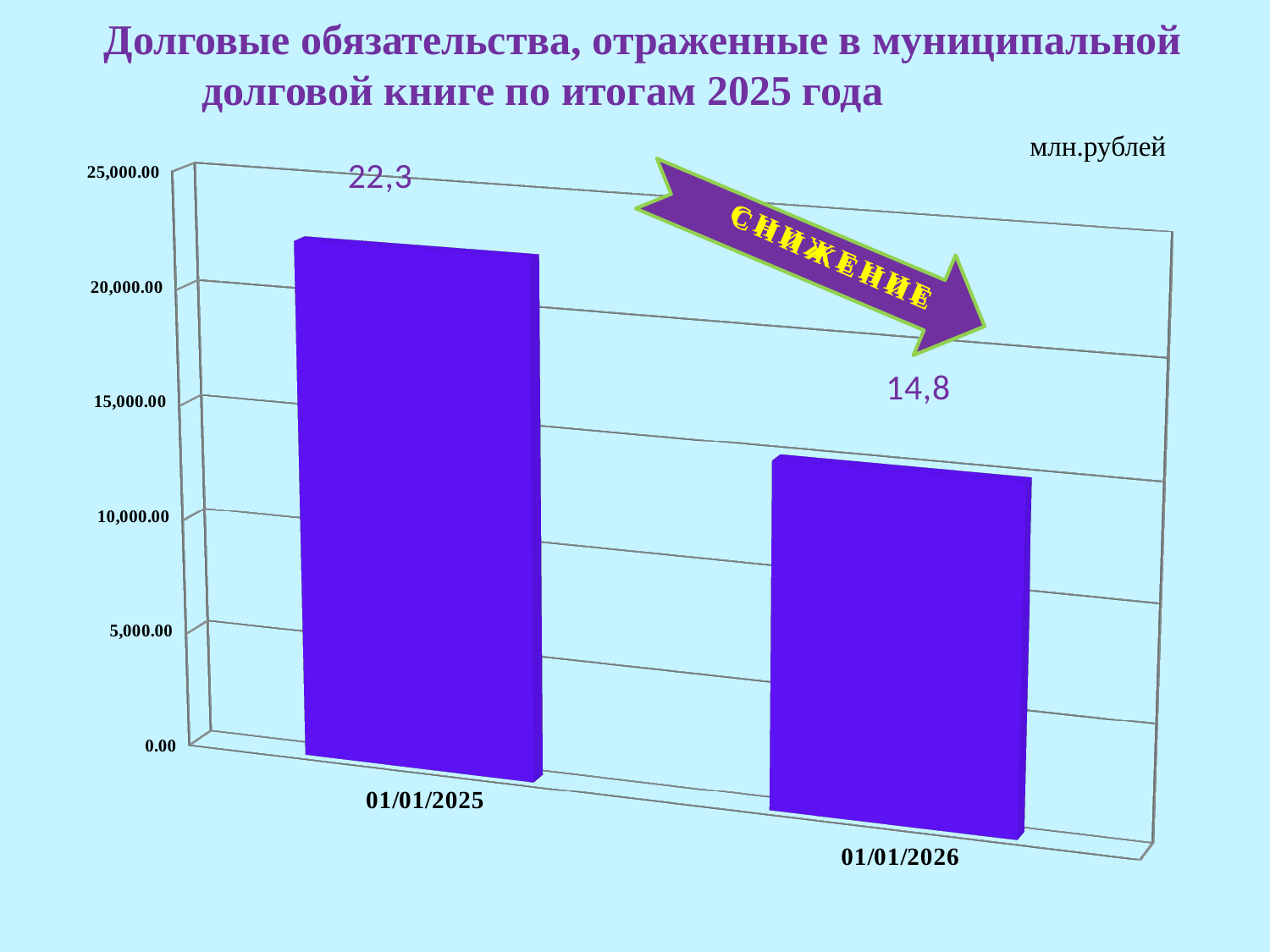
What unit of measurement is indicated on the slide for the chart values? млн.рублей What is the difference between the labelled values for 01/01/2025 and 01/01/2026? 7,5 Which category has the lowest value on the chart? 01/01/2026 Is the bar for 01/01/2025 greater or less than 20,000.00 on the axis? greater How many bars are shown on the chart? 2 What value is labelled on the bar for 01/01/2026? 14,8 Which category has the highest value on the chart? 01/01/2025 Which date has the higher value, 01/01/2025 or 01/01/2026? 01/01/2025 Is the bar for 01/01/2026 greater or less than 10,000.00 on the axis? greater What value is labelled on the bar for 01/01/2025? 22,3 Do the values rise or fall from 01/01/2025 to 01/01/2026? Fall What kind of chart is shown on the slide? Bar chart